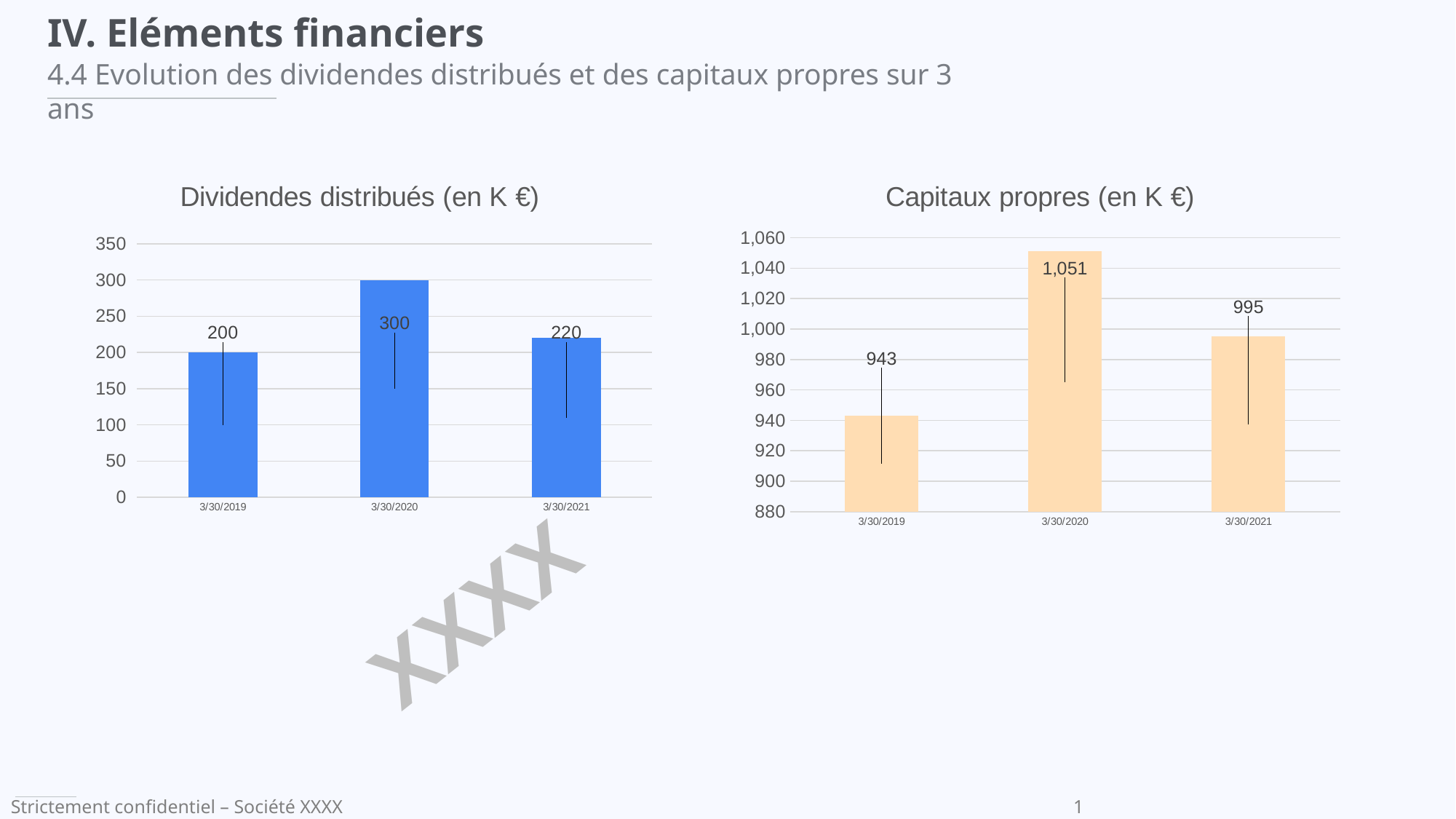
In the 'Dividendes distribués (en K €)' chart, which date has the highest value? 3/30/2020 In the 'Dividendes distribués (en K €)' chart, what is the value for 3/30/2021? 220 What type of chart is the 'Capitaux propres (en K €)' chart? bar chart What colour are the bars in the 'Dividendes distribués (en K €)' chart? blue How many bars are shown in the 'Dividendes distribués (en K €)' chart? 3 In the 'Dividendes distribués (en K €)' chart, what is the difference between the values for 3/30/2020 and 3/30/2019? 100 In the 'Capitaux propres (en K €)' chart, which date has the lowest value? 3/30/2019 In the 'Capitaux propres (en K €)' chart, what is the value for 3/30/2021? 995 In the 'Dividendes distribués (en K €)' chart, what is the value for 3/30/2020? 300 In the 'Capitaux propres (en K €)' chart, which is larger: the value for 3/30/2019 or the value for 3/30/2021? 3/30/2021 In the 'Capitaux propres (en K €)' chart, what is the value for 3/30/2019? 943 In the 'Capitaux propres (en K €)' chart, what is the difference between the values for 3/30/2020 and 3/30/2021? 56